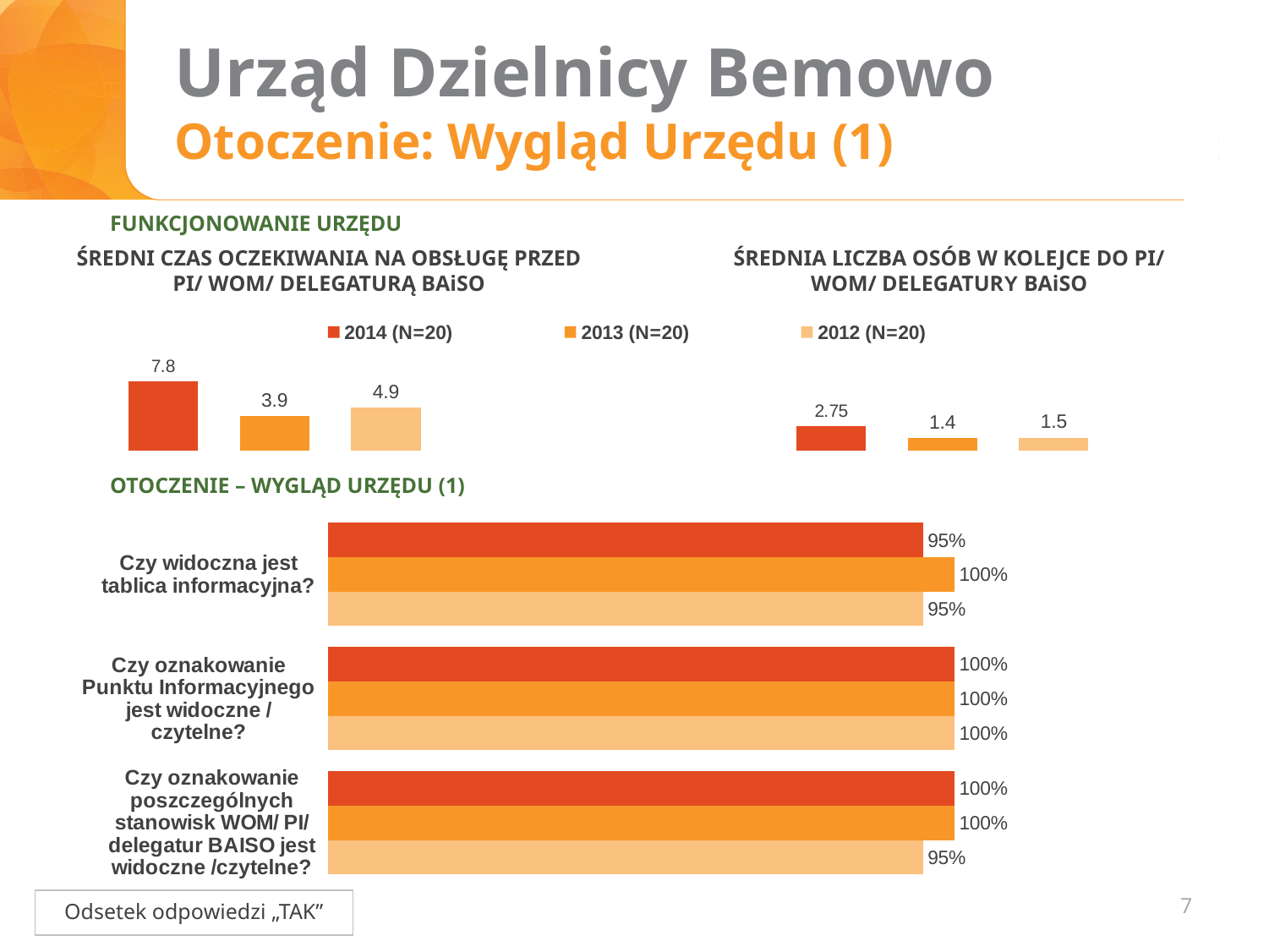
In the chart titled "ŚREDNIA LICZBA OSÓB W KOLEJCE DO PI/ WOM/ DELEGATURY BAiSO", which year has the highest value? 2014 (N=20) In the chart titled "ŚREDNI CZAS OCZEKIWANIA NA OBSŁUGĘ PRZED PI/ WOM/ DELEGATURĄ BAiSO", which year has the lowest value? 2013 (N=20) In the bottom chart (OTOCZENIE – WYGLĄD URZĘDU (1)), what is the 2013 value for "Czy widoczna jest tablica informacyjna?"? 100% In the chart titled "ŚREDNIA LICZBA OSÓB W KOLEJCE DO PI/ WOM/ DELEGATURY BAiSO", what is the value for 2012 (N=20)? 1.5 In the bottom chart (OTOCZENIE – WYGLĄD URZĘDU (1)), how many question categories are shown? 3 What type of chart is the bottom chart (OTOCZENIE – WYGLĄD URZĘDU (1))? Bar chart How many series does the legend above the top charts list? 3 In the chart titled "ŚREDNI CZAS OCZEKIWANIA NA OBSŁUGĘ PRZED PI/ WOM/ DELEGATURĄ BAiSO", what is the difference between the 2014 and 2013 values? 3.9 In the bottom chart (OTOCZENIE – WYGLĄD URZĘDU (1)), what is the 2012 value for "Czy oznakowanie poszczególnych stanowisk WOM/ PI/ delegatur BAISO jest widoczne /czytelne?"? 95% In the chart titled "ŚREDNI CZAS OCZEKIWANIA NA OBSŁUGĘ PRZED PI/ WOM/ DELEGATURĄ BAiSO", what is the value for 2014 (N=20)? 7.8 In the chart titled "ŚREDNIA LICZBA OSÓB W KOLEJCE DO PI/ WOM/ DELEGATURY BAiSO", what is the value for 2014 (N=20)? 2.75 In the bottom chart (OTOCZENIE – WYGLĄD URZĘDU (1)), is the 2014 value for "Czy widoczna jest tablica informacyjna?" larger or smaller than the 2013 value? Smaller